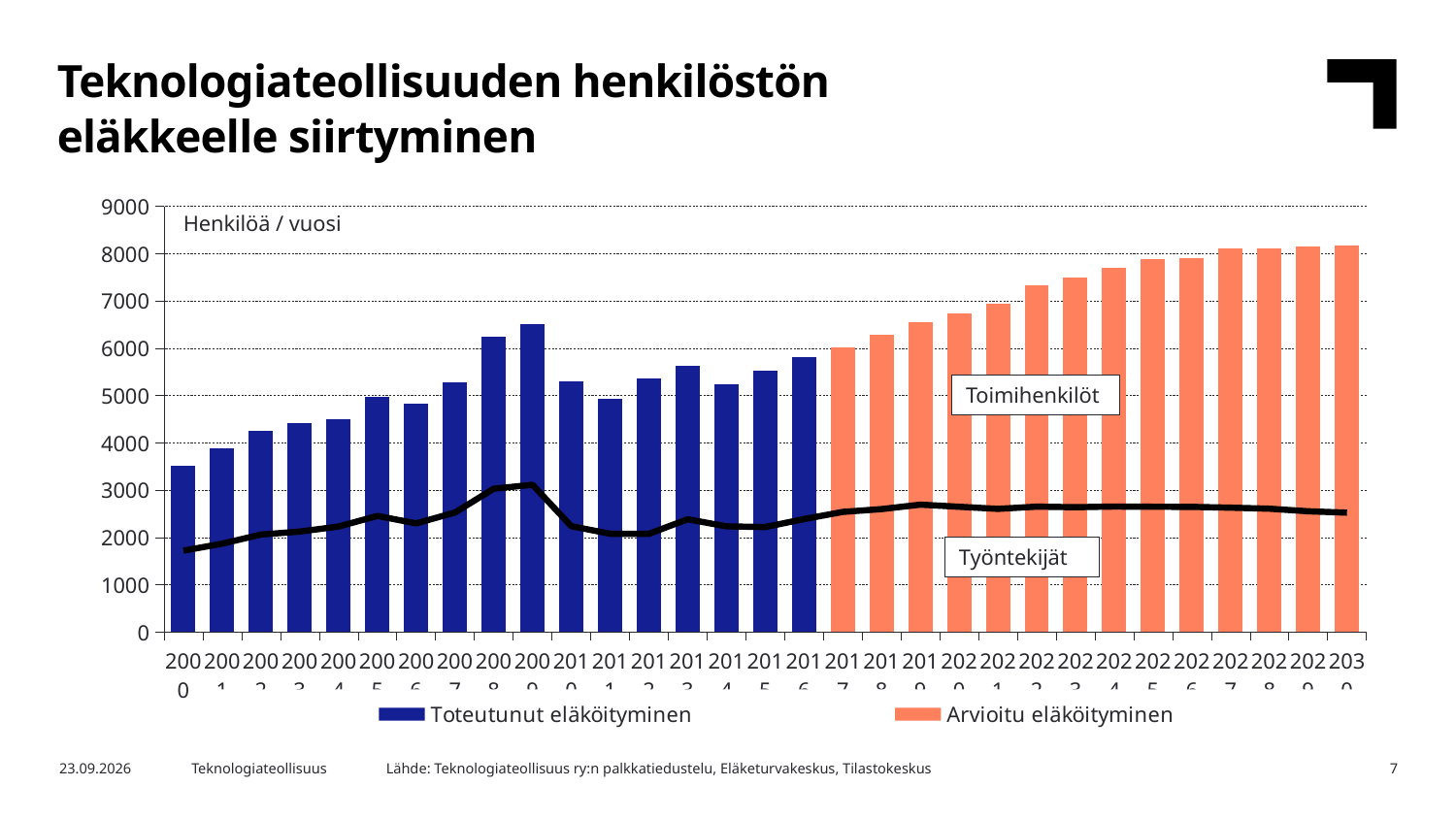
Which year has the lowest bar? 2000 How many series does the legend list? 2 Is the bar for 2020 greater or less than 6000? greater Do the Arvioitu eläköityminen bars rise or fall from 2017 to 2030? rise What are the two legend entries? Toteutunut eläköityminen and Arvioitu eläköityminen Which bar is taller, 2015 or 2016? 2016 Which bar is taller, 2008 or 2009? 2009 What kind of chart is shown on the slide? Combination bar and line chart What unit label is shown at the top of the y axis? Henkilöä / vuosi Is the bar for 2000 greater or less than 4000? less How many years (bars) are shown on the x axis? 31 Is the bar for 2009 greater or less than 6000? greater